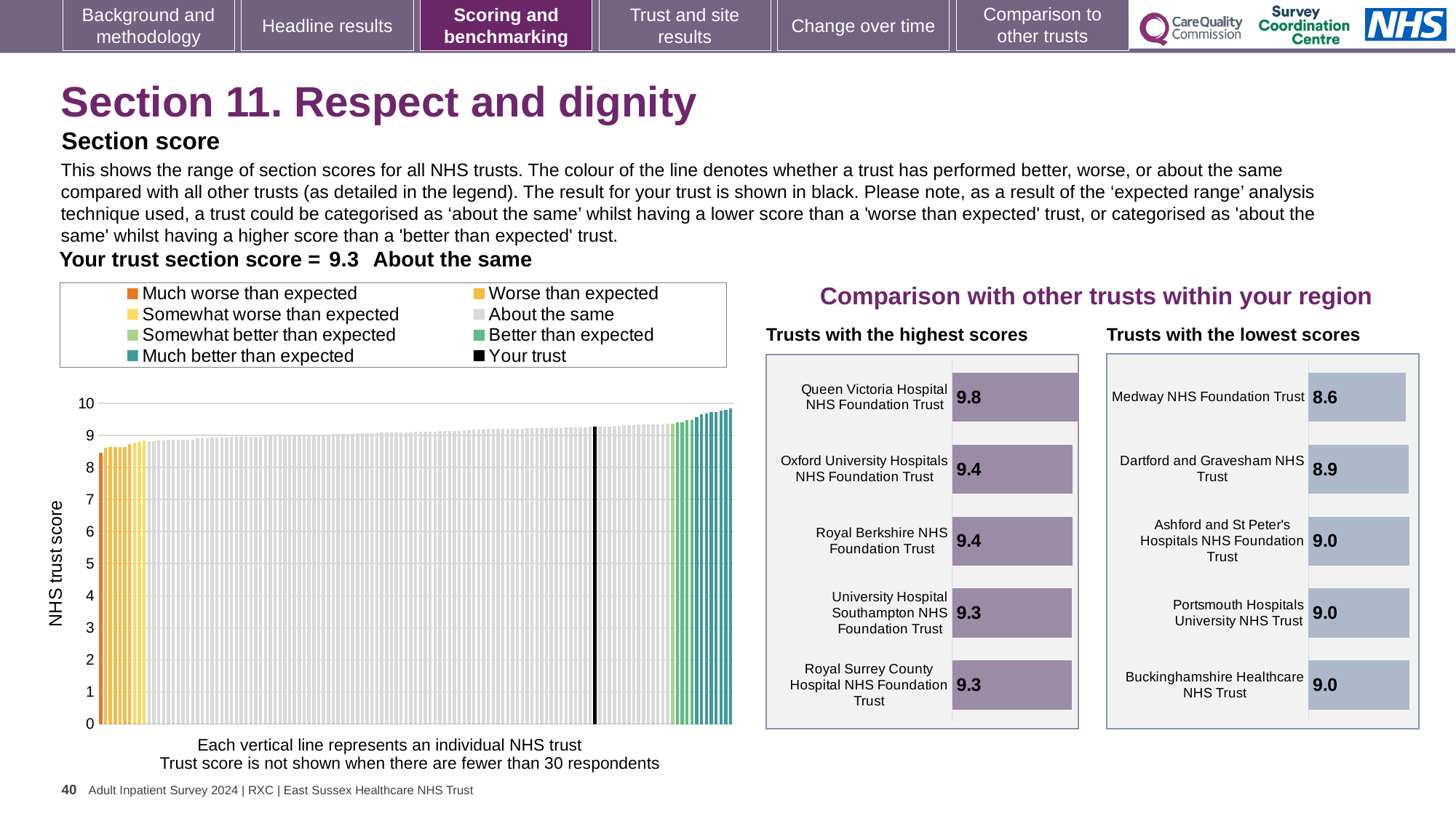
In the 'Trusts with the lowest scores' chart, what is the difference between the scores of Dartford and Gravesham NHS Trust and Medway NHS Foundation Trust? 0.3 What is the section score for your trust shown in the main NHS trust score chart? 9.3 In the 'Trusts with the lowest scores' chart, what is the score for Medway NHS Foundation Trust? 8.6 In the 'Trusts with the highest scores' chart, what is the score for Queen Victoria Hospital NHS Foundation Trust? 9.8 In the 'Trusts with the highest scores' chart, which has the higher score: Oxford University Hospitals NHS Foundation Trust or University Hospital Southampton NHS Foundation Trust? Oxford University Hospitals NHS Foundation Trust In the 'Trusts with the highest scores' chart, what is the difference between the scores of Queen Victoria Hospital NHS Foundation Trust and Royal Surrey County Hospital NHS Foundation Trust? 0.5 In the 'Trusts with the lowest scores' chart, which trust has the lowest score? Medway NHS Foundation Trust How many entries does the legend of the main NHS trust score chart list? 8 What kind of chart is the main NHS trust score chart on the left? bar chart How many trusts are shown in the 'Trusts with the lowest scores' chart? 5 In the 'Trusts with the highest scores' chart, which trust has the highest score? Queen Victoria Hospital NHS Foundation Trust In the main NHS trust score chart, is the value for the black 'Your trust' bar greater or less than 9? greater